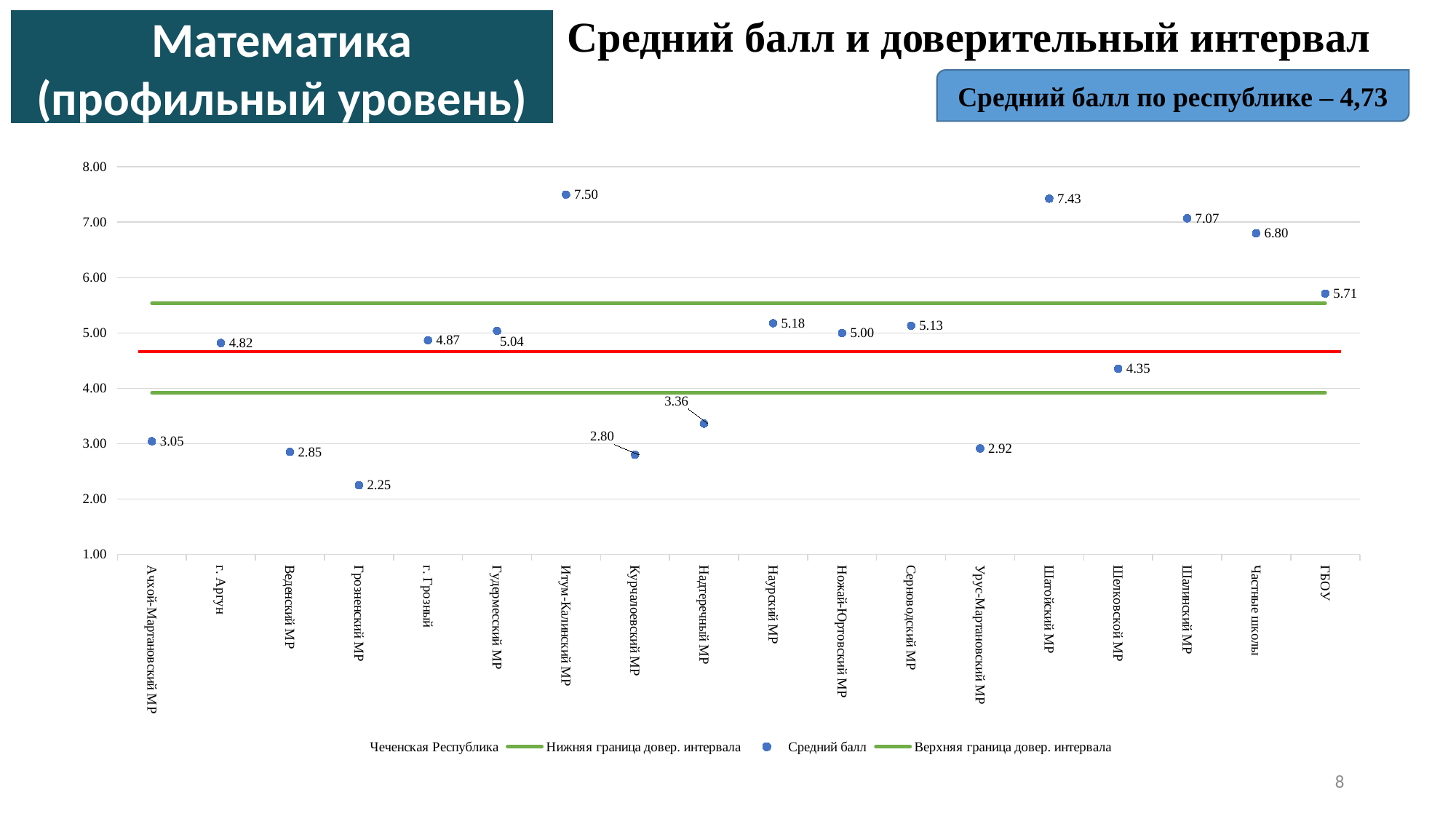
Which has a higher average score, Наурский МР or Серноводский МР? Наурский МР How many categories are shown on the x axis of the chart? 18 What is the difference between the average scores of Шатойский МР and Шелковской МР? 3.08 How many entries does the chart legend list? 4 Is the average score for Шалинский МР greater or less than 7.00? greater Which category has the highest average score? Итум-Калинский МР What is the average score (Средний балл) for Итум-Калинский МР? 7.50 Which category has the lowest average score? Грозненский МР What is the average score for Грозненский МР? 2.25 What is the average score for Частные школы? 6.80 What is the average score for ГБОУ? 5.71 What is the republic-wide average score stated on the slide? 4,73